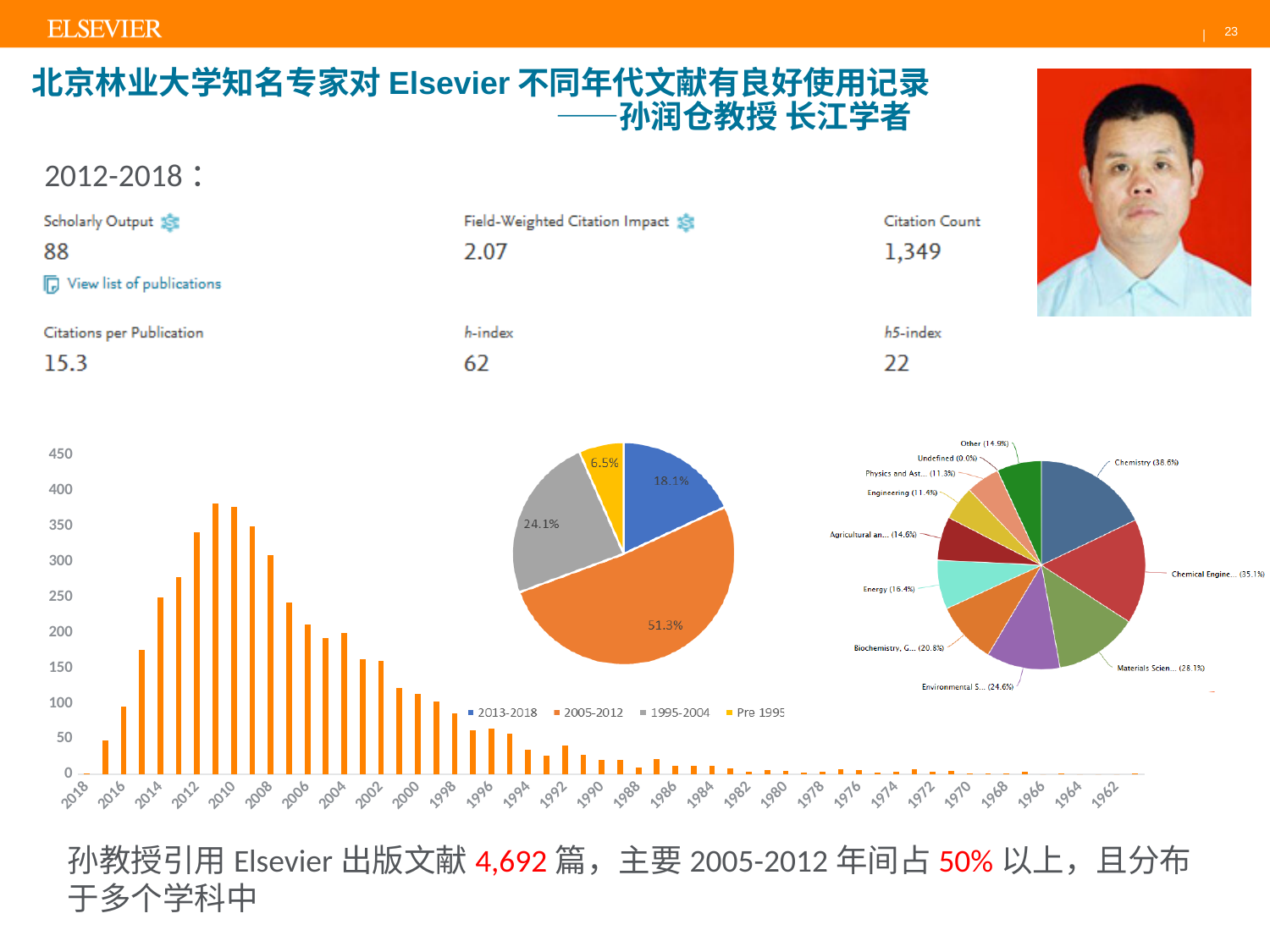
In the middle pie chart, what share does the 2005-2012 slice have? 51.3% In the bar chart on the left, is the value for 1990 greater or less than 50? less In the middle pie chart, which period has the largest share? 2005-2012 In the bar chart on the left, is the value for 2010 greater or less than 350? greater In the middle pie chart, which period has the smallest share? Pre 1995 In the right-hand pie chart, what percentage is shown for Chemistry? 38.6% In the middle pie chart, what is the difference between the 2005-2012 share and the 2013-2018 share? 33.2% How many entries does the legend of the middle pie chart list? 4 What kind of chart is the chart on the left of the slide (years 2018 to 1962)? bar chart In the bar chart on the left, is the value for 2004 greater or less than 150? greater In the bar chart on the left, moving along the x axis from 2010 to 1990, do the values rise or fall? fall In the right-hand pie chart, which category has the largest percentage? Chemistry